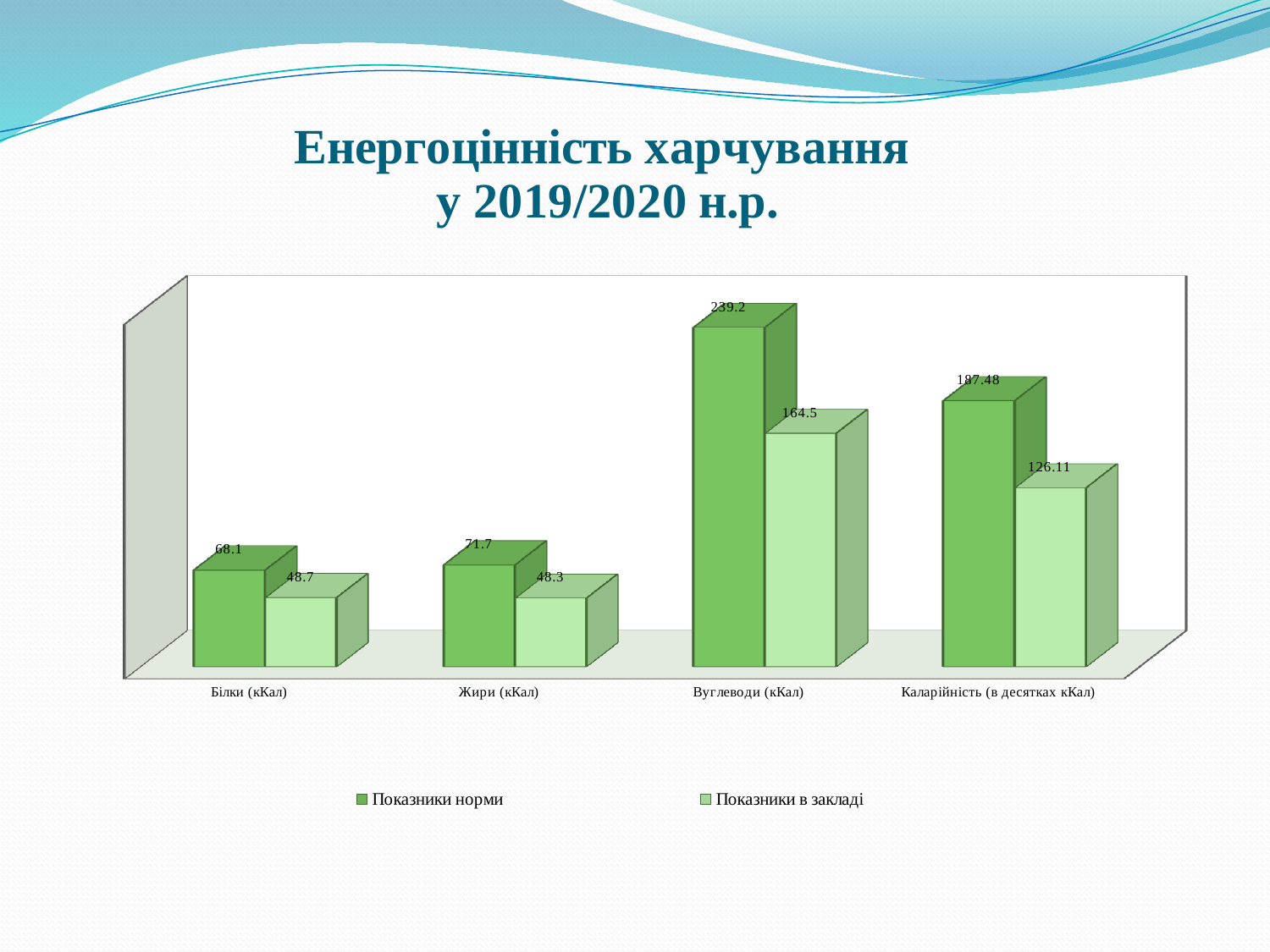
Which is larger for Каларійність (в десятках кКал): Показники норми or Показники в закладі? Показники норми What is the value of Показники в закладі for Жири (кКал)? 48.3 How many categories are shown on the x axis? 4 What is the value of Показники норми for Каларійність (в десятках кКал)? 187.48 What is the difference between Показники норми and Показники в закладі for Вуглеводи (кКал)? 74.7 What is the title of the slide? Енергоцінність харчування у 2019/2020 н.р. Which category has the lowest value for Показники в закладі? Жири (кКал) How many series does the legend list? 2 Which category has the highest value for Показники норми? Вуглеводи (кКал) What kind of chart is shown on the slide? Bar chart What is the value of Показники норми for Вуглеводи (кКал)? 239.2 What is the value of Показники в закладі for Білки (кКал)? 48.7